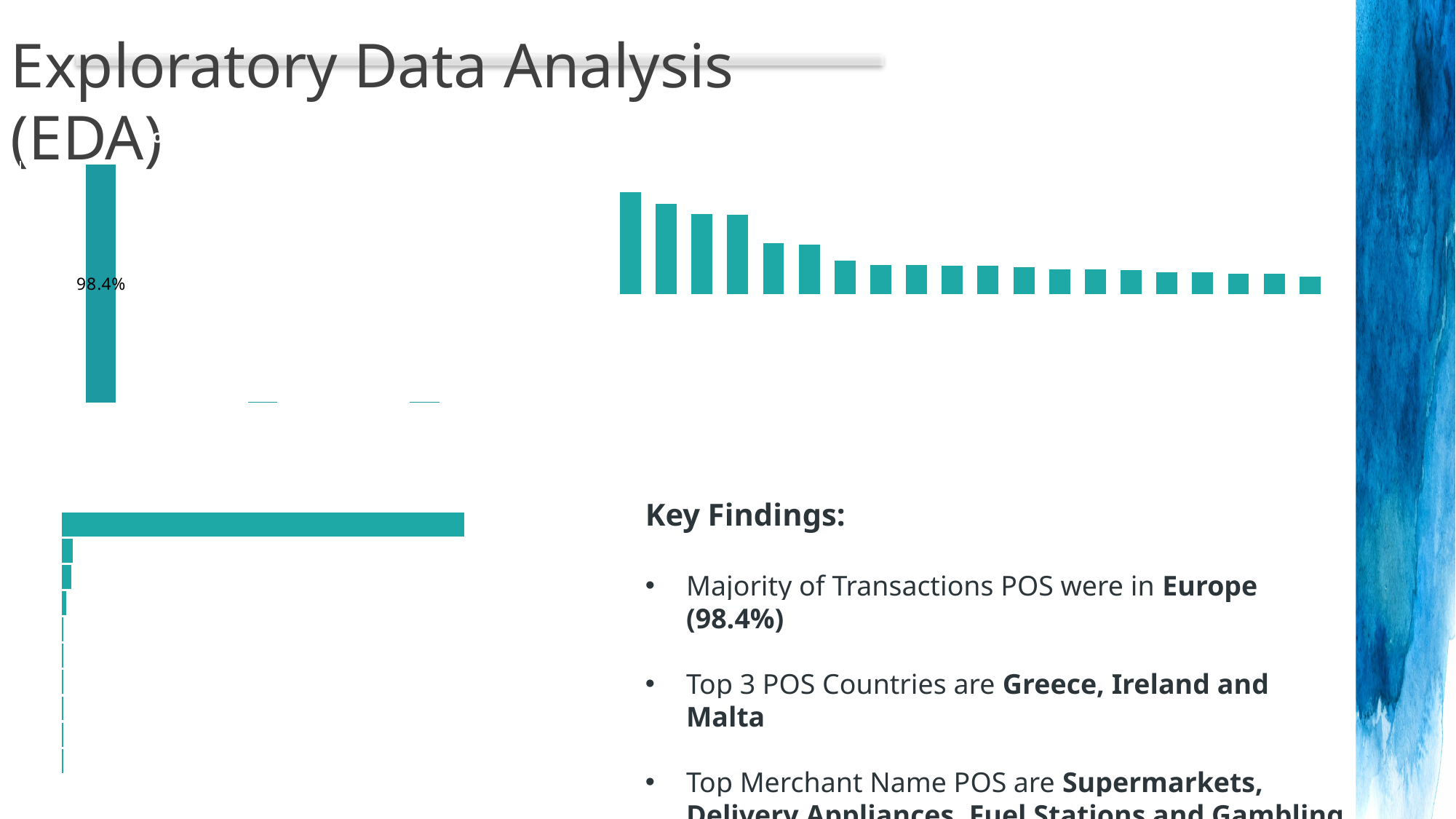
What kind of chart is the chart in the top-left of the slide? bar chart In the top-right chart, which bar is the highest: the leftmost or the rightmost? the leftmost How many bars does the top-right chart show? 20 In the top-right chart, do the bar values rise or fall from left to right? fall How many bars does the top-left chart show? 3 In the bottom-left chart, are the bars horizontal or vertical? horizontal What kind of chart is the chart in the bottom-left of the slide? bar chart In the bottom-left chart, is the top bar longer or shorter than the second bar? longer In the top-left chart, what value is printed on the tallest bar? 98.4% What kind of chart is the chart in the top-right of the slide? bar chart What colour are the bars in the charts on the slide? teal